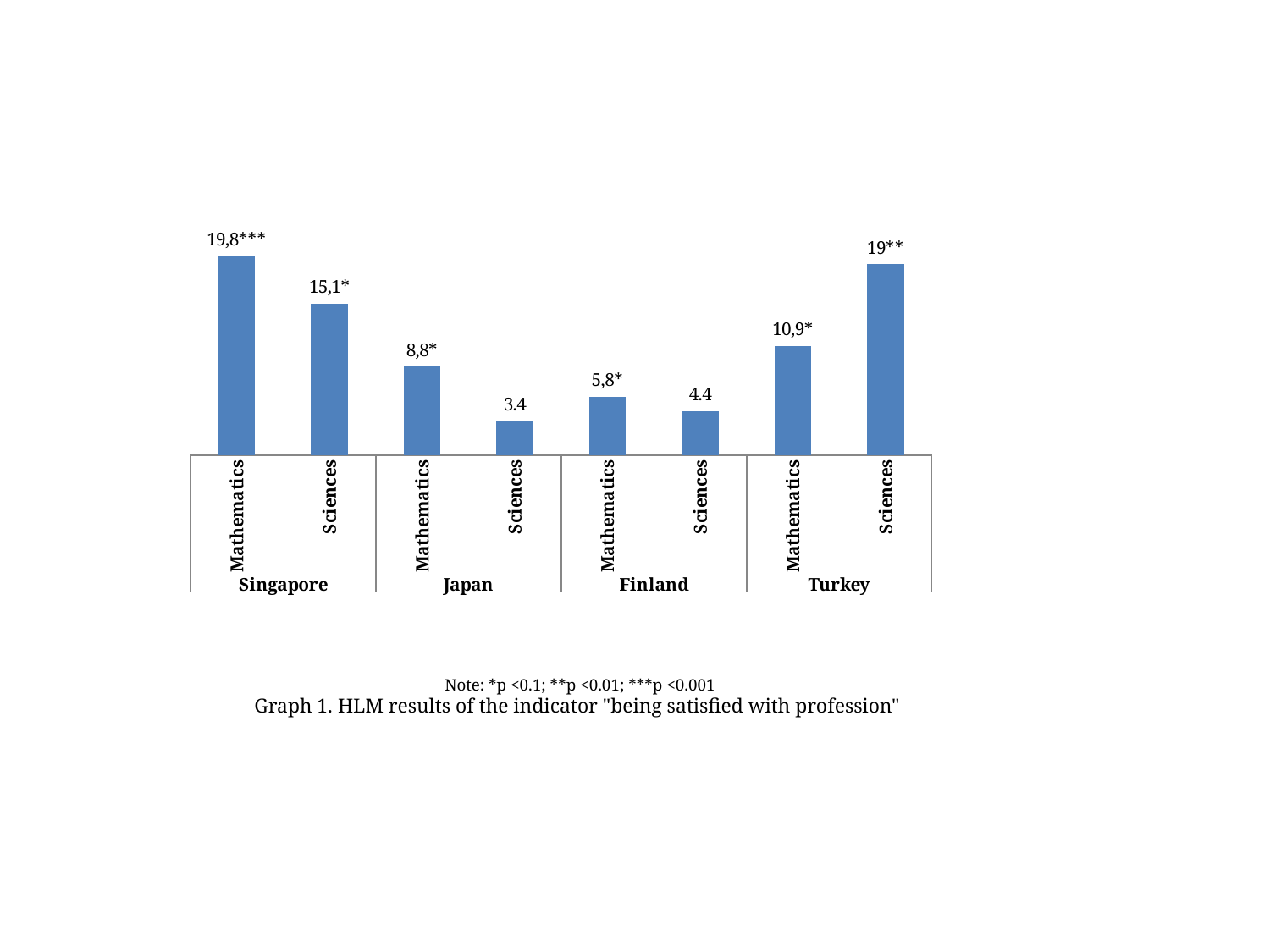
Which is larger: the Mathematics bar for Japan or the Mathematics bar for Turkey? Turkey Mathematics Which is larger for Finland: Mathematics or Sciences? Mathematics How many countries are shown on the x axis of the chart? 4 Which bar has the highest value in the chart? Singapore Mathematics What is the data label on the Sciences bar for Japan? 3.4 Which bar has the lowest value in the chart? Japan Sciences What is the data label on the Mathematics bar for Singapore? 19,8*** How many bars are plotted in the chart? 8 What is the data label on the Mathematics bar for Finland? 5,8* What is the data label on the Sciences bar for Turkey? 19** What is the title of the chart given below it? Graph 1. HLM results of the indicator "being satisfied with profession" What kind of chart is shown on the slide? Bar chart